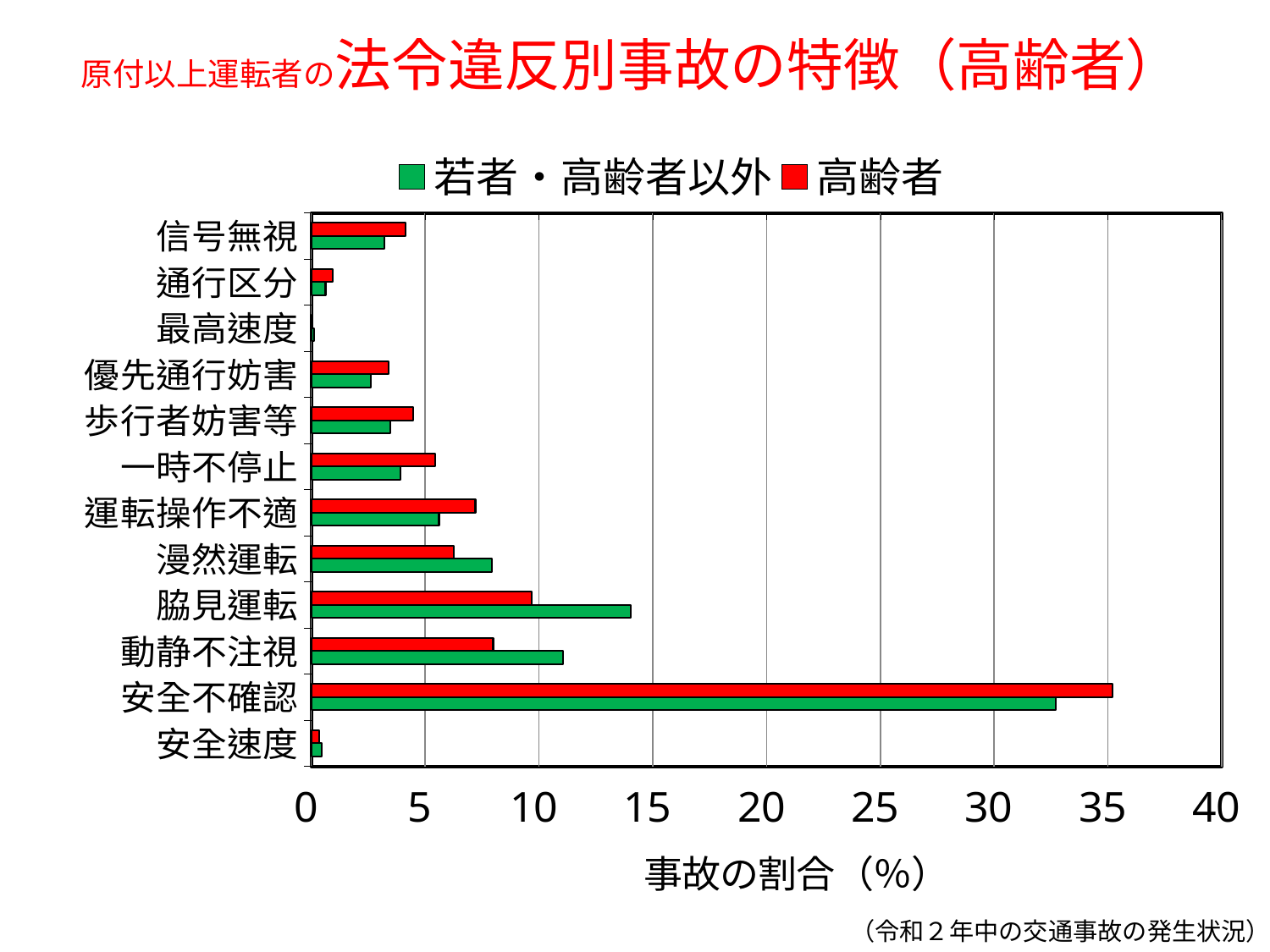
Which category has the highest value for 若者・高齢者以外? 安全不確認 Which colour represents the 高齢者 series in the legend? red Is the 高齢者 value for 脇見運転 greater or less than 10? less What is the label of the horizontal axis? 事故の割合（%） For 脇見運転, which series has the larger value, 若者・高齢者以外 or 高齢者? 若者・高齢者以外 How many series does the legend list? 2 Which category has the highest value for 高齢者? 安全不確認 Is the 若者・高齢者以外 value for 脇見運転 greater or less than 10? greater What kind of chart is shown on the slide? bar chart How many violation categories are plotted on the chart? 12 For 運転操作不適, which series has the larger value, 若者・高齢者以外 or 高齢者? 高齢者